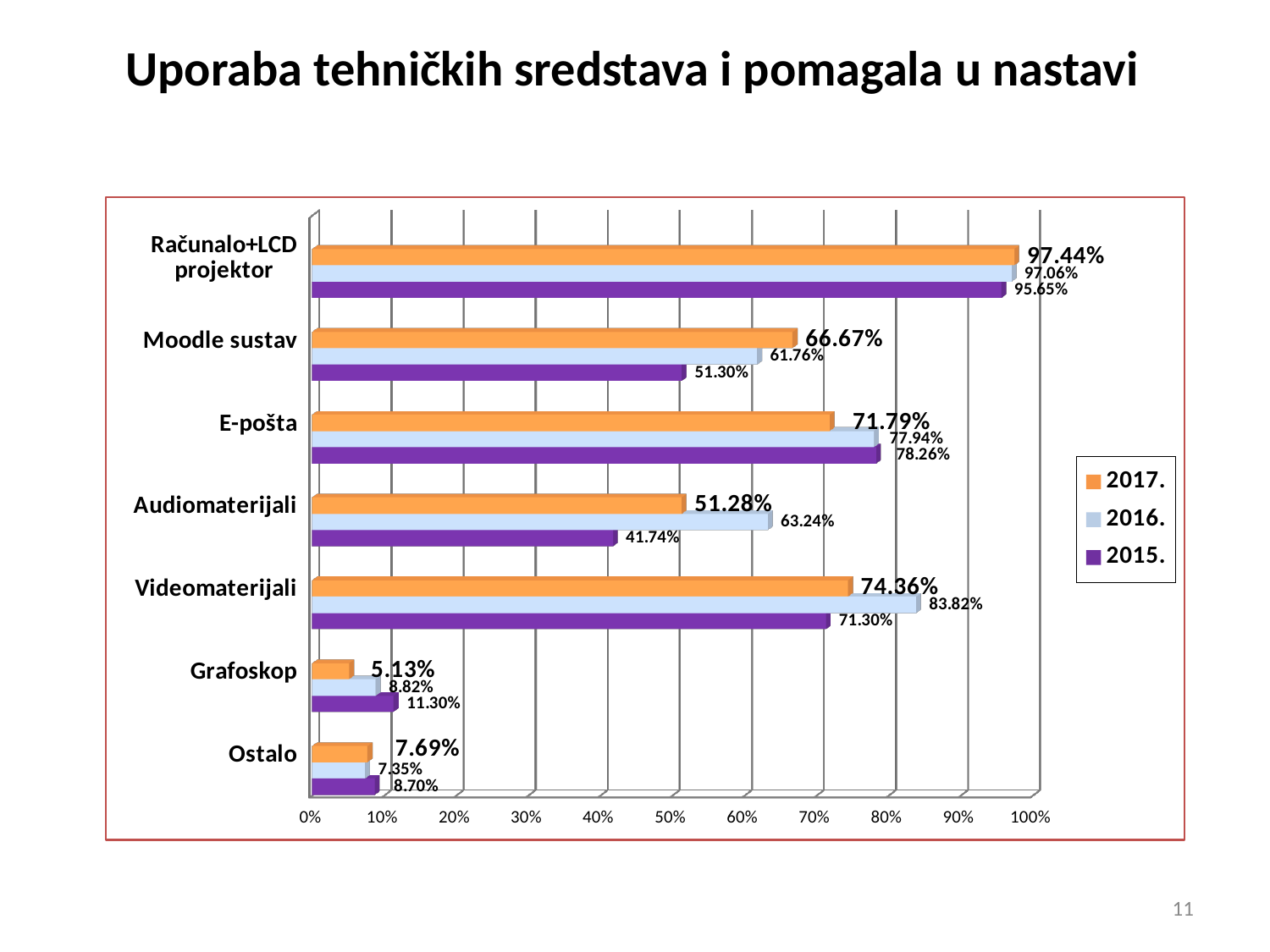
How many series does the legend list? 3 What is the title of the slide? Uporaba tehničkih sredstava i pomagala u nastavi Which category has the highest value in the 2017. series? Računalo+LCD projektor What is the difference between the 2017. and 2015. values for Moodle sustav? 15.37% Is the 2015. value for Audiomaterijali greater or less than 50%? less What is the value for Audiomaterijali in the 2016. series? 63.24% Which category has the lowest value in the 2017. series? Grafoskop What kind of chart is shown on the slide? bar chart What is the value for Moodle sustav in the 2015. series? 51.30% How many categories are shown on the chart? 7 Which is larger for Videomaterijali: the 2016. value or the 2017. value? 2016. What is the value for Računalo+LCD projektor in the 2017. series? 97.44%